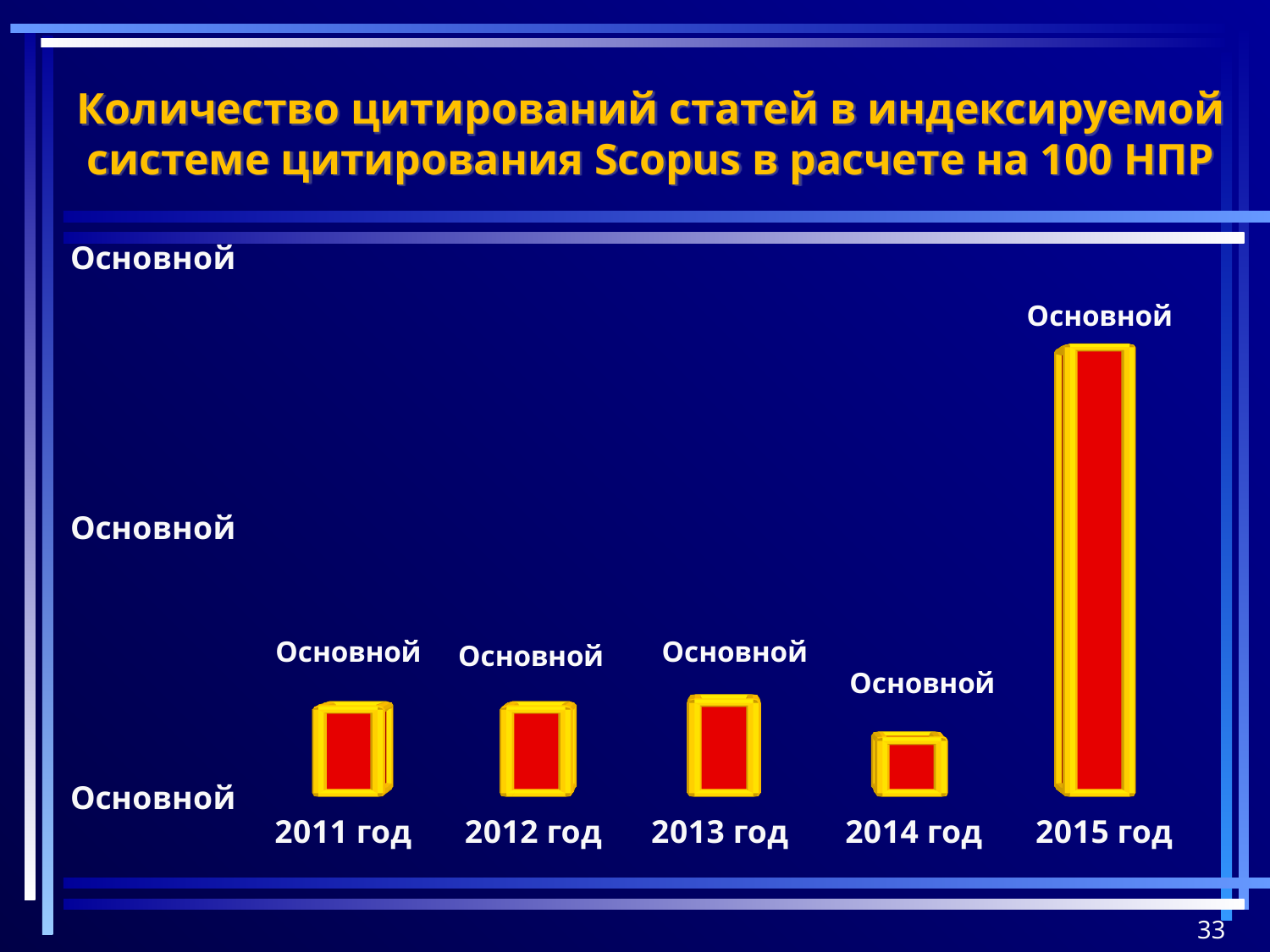
Which bar is taller, 2015 год or 2014 год? 2015 год Does the value fall or rise from 2013 год to 2014 год? fall What is the title of the chart on the slide? Количество цитирований статей в индексируемой системе цитирования Scopus в расчете на 100 НПР Which bar is taller, 2011 год or 2015 год? 2015 год Which year has the highest bar on the chart? 2015 год Which bar is taller, 2013 год or 2014 год? 2013 год Does the value fall or rise from 2014 год to 2015 год? rise How many years (categories) are plotted on the chart? 5 What kind of chart is shown on the slide? bar chart Which year has the lowest bar on the chart? 2014 год What colour are the bars on the chart? red with yellow borders